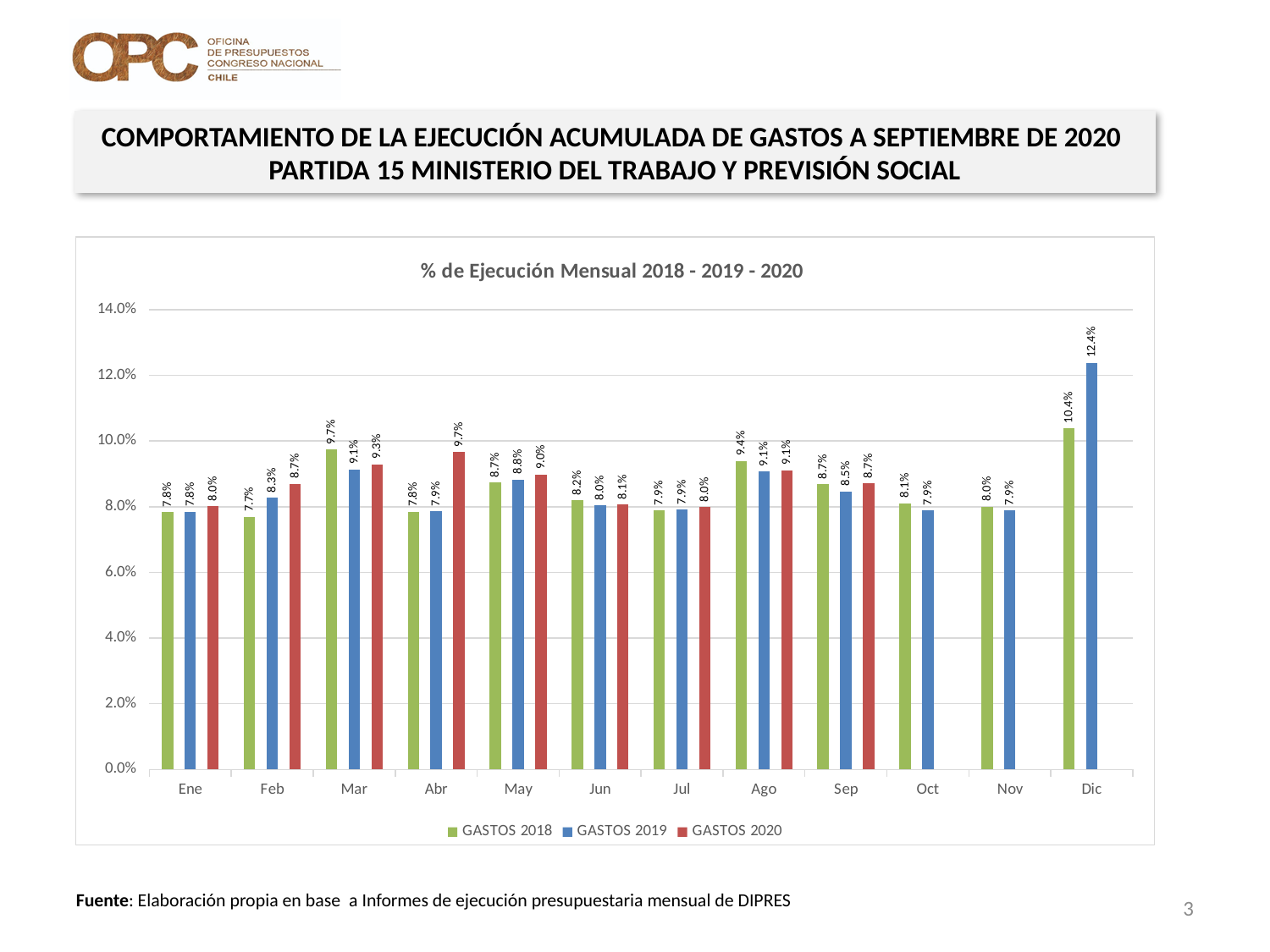
What kind of chart is shown on the slide? Bar chart What is the value for GASTOS 2019 in Dic? 12.4% What is the value for GASTOS 2018 in Mar? 9.7% What is the difference between GASTOS 2019 and GASTOS 2018 in Dic? 2.0% What is the title of the chart? % de Ejecución Mensual 2018 - 2019 - 2020 Is the value for GASTOS 2019 in Dic greater or less than 12.0%? greater Which month has the highest value for GASTOS 2018? Dic How many series does the legend list? 3 How many months are shown on the x axis? 12 What is the value for GASTOS 2020 in Abr? 9.7% Which month has the lowest value for GASTOS 2018? Feb Which is larger in Feb: GASTOS 2019 or GASTOS 2020? GASTOS 2020